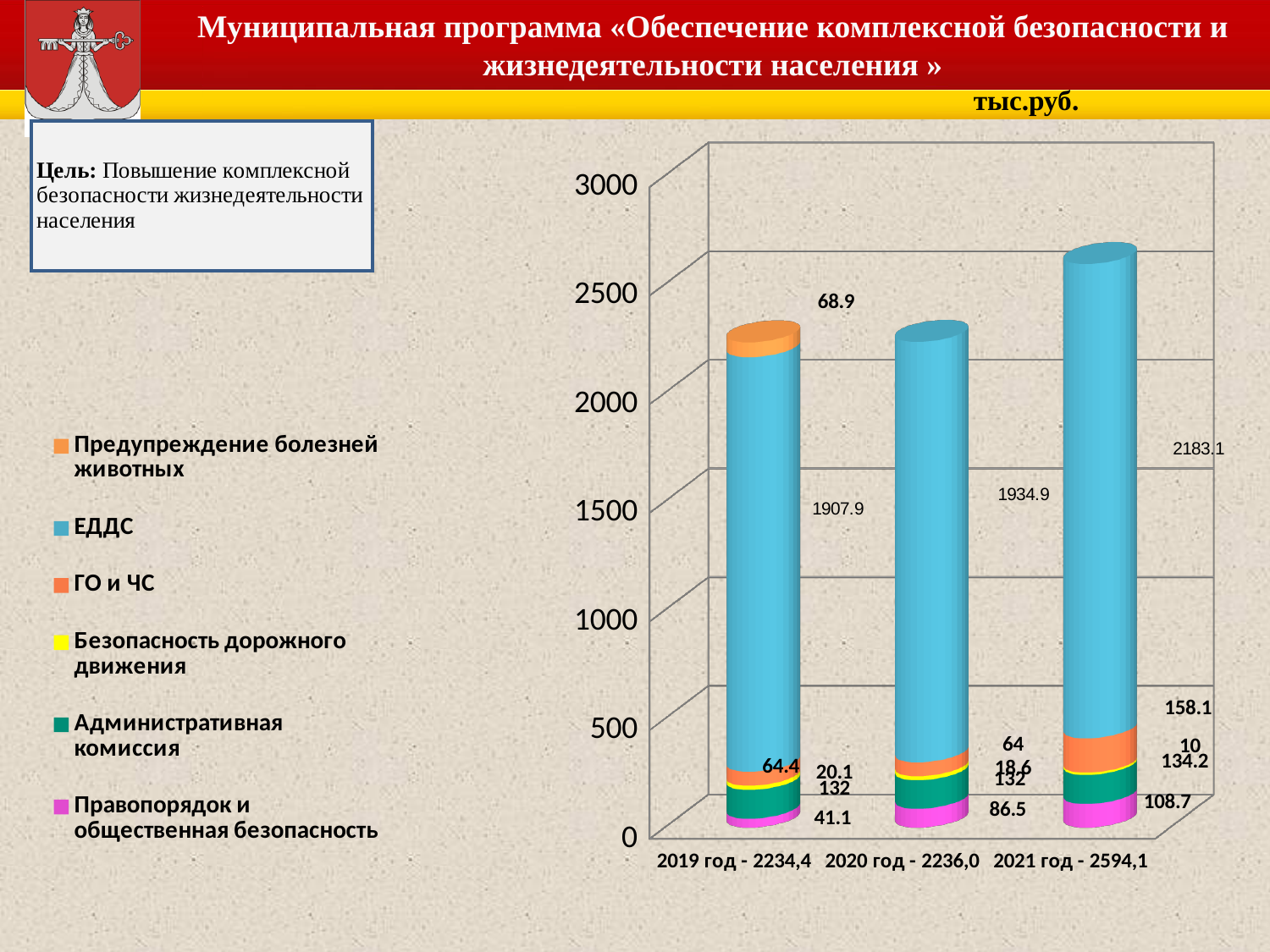
In which year is the Правопорядок и общественная безопасность value lowest? 2019 год What is the value of ГО и ЧС for 2020 год? 64 In which year is the ЕДДС value highest? 2021 год What is the total of the stacked bar for 2021 год? 2594,1 Does the ЕДДС value rise or fall from 2019 to 2021? rise What is the difference between the ЕДДС values for 2021 год and 2020 год? 248.2 What is the value of Правопорядок и общественная безопасность for 2021 год? 108.7 How many series does the legend list? 6 What is the value of ЕДДС for 2019 год? 1907.9 Which is larger: ГО и ЧС for 2021 год or ГО и ЧС for 2019 год? 2021 год How many years (categories) are shown on the x axis? 3 What kind of chart is shown on the slide? stacked bar chart